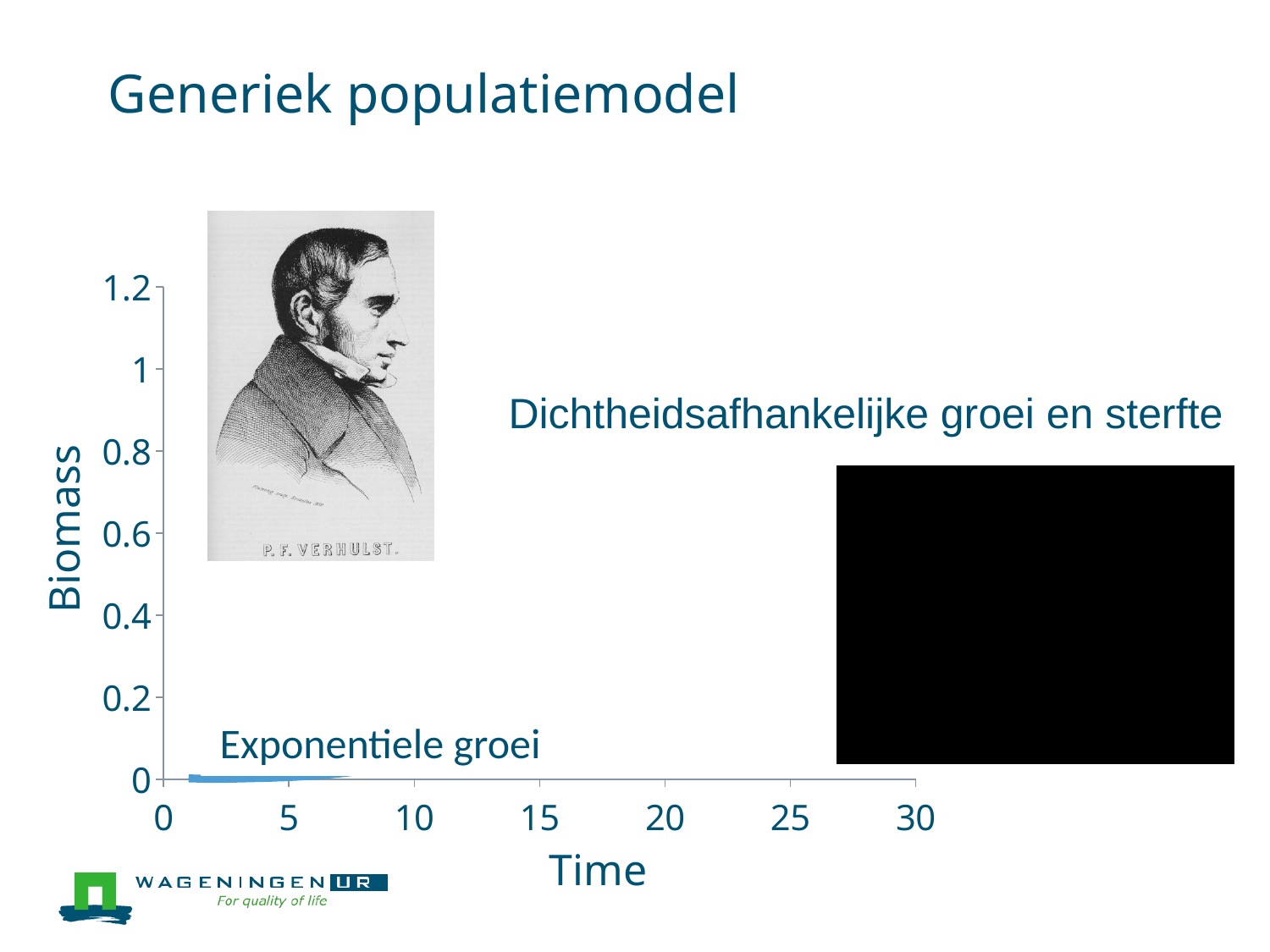
What is the highest tick value shown on the Time axis? 30 What kind of chart is shown on the slide? line chart What is the highest tick value shown on the Biomass axis? 1.2 Is the plotted biomass value at time 5 greater or less than 0.2? less What is the interval between consecutive tick labels on the Time axis? 5 How many tick labels are shown on the Time axis? 7 What is the label of the horizontal axis of the chart? Time What is the label of the vertical axis of the chart? Biomass